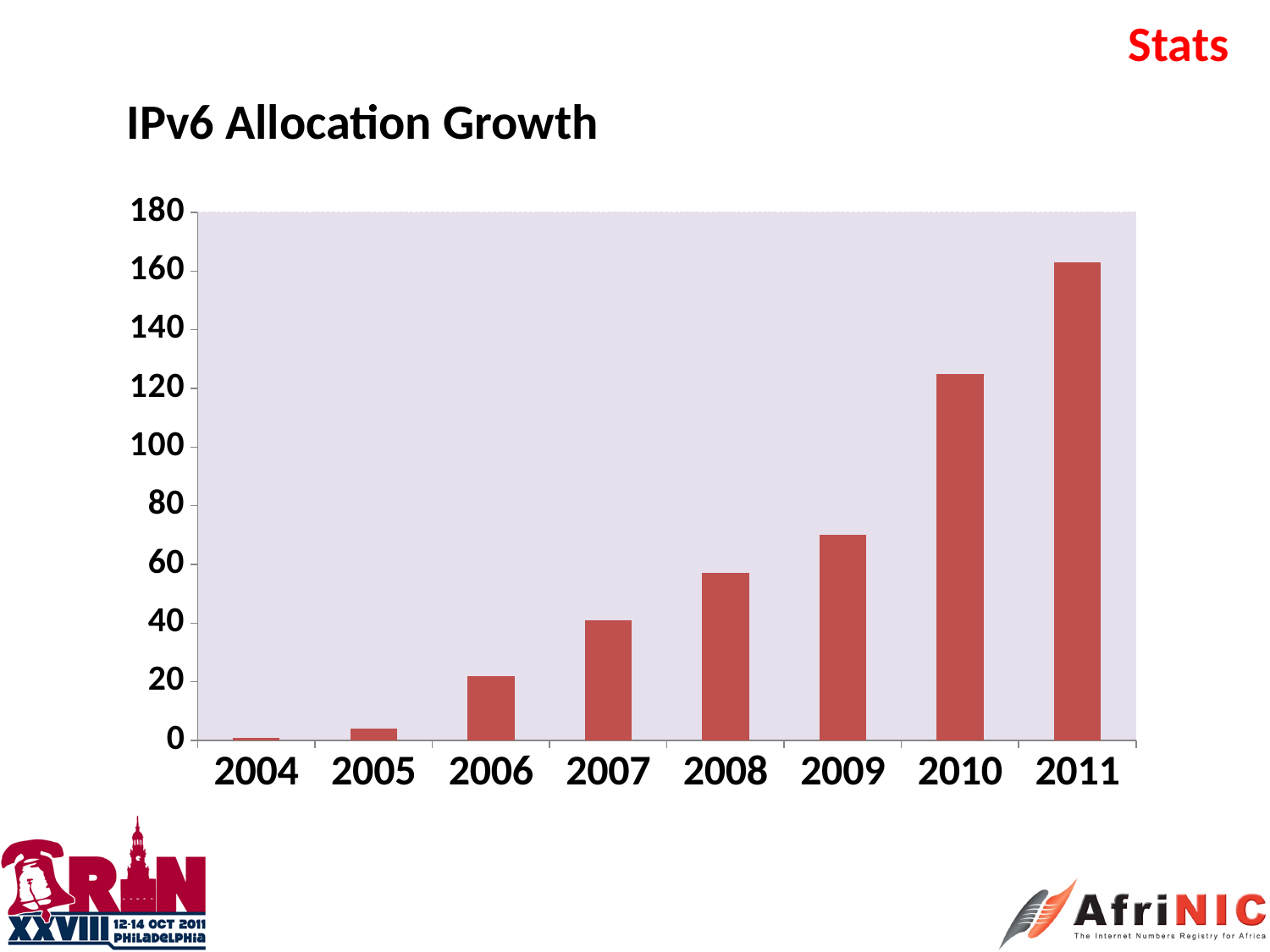
How many years are shown on the x axis of the chart? 8 What is the highest value shown on the y axis of the chart? 180 Is the value for 2006 greater or less than 40? less What kind of chart is shown on the slide? bar chart Which is larger, the value for 2008 or the value for 2007? 2008 Do the values rise or fall from 2004 to 2011? rise Is the value for 2010 greater or less than 120? greater Which year has the lowest bar in the chart? 2004 Is the value for 2009 greater or less than 80? less What is the title of the chart? IPv6 Allocation Growth Which year has the highest bar in the chart? 2011